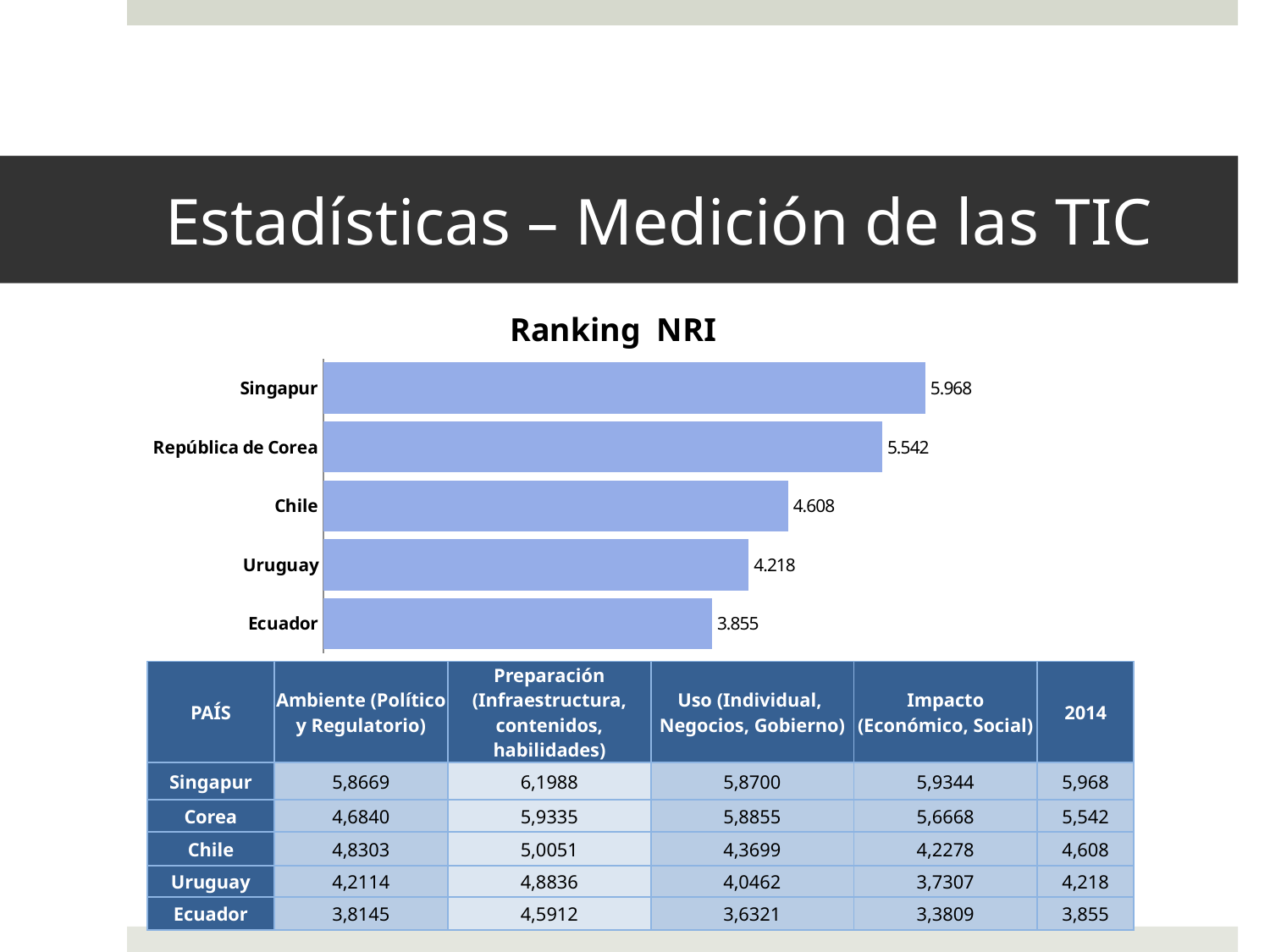
What is the NRI value shown for Singapur in the Ranking NRI chart? 5.968 In the Ranking NRI chart, which has a larger value, Uruguay or Ecuador? Uruguay Which country has the highest value in the Ranking NRI chart? Singapur How many countries are shown in the Ranking NRI chart? 5 In the Ranking NRI chart, what is the difference between the values for Chile and Uruguay? 0.390 Which country has the lowest value in the Ranking NRI chart? Ecuador What is the title of the chart on the slide? Ranking NRI What type of chart is the Ranking NRI chart? Bar chart In the Ranking NRI chart, what is the difference between the values for Singapur and República de Corea? 0.426 What is the NRI value shown for República de Corea in the Ranking NRI chart? 5.542 What is the NRI value shown for Ecuador in the Ranking NRI chart? 3.855 What is the NRI value shown for Chile in the Ranking NRI chart? 4.608